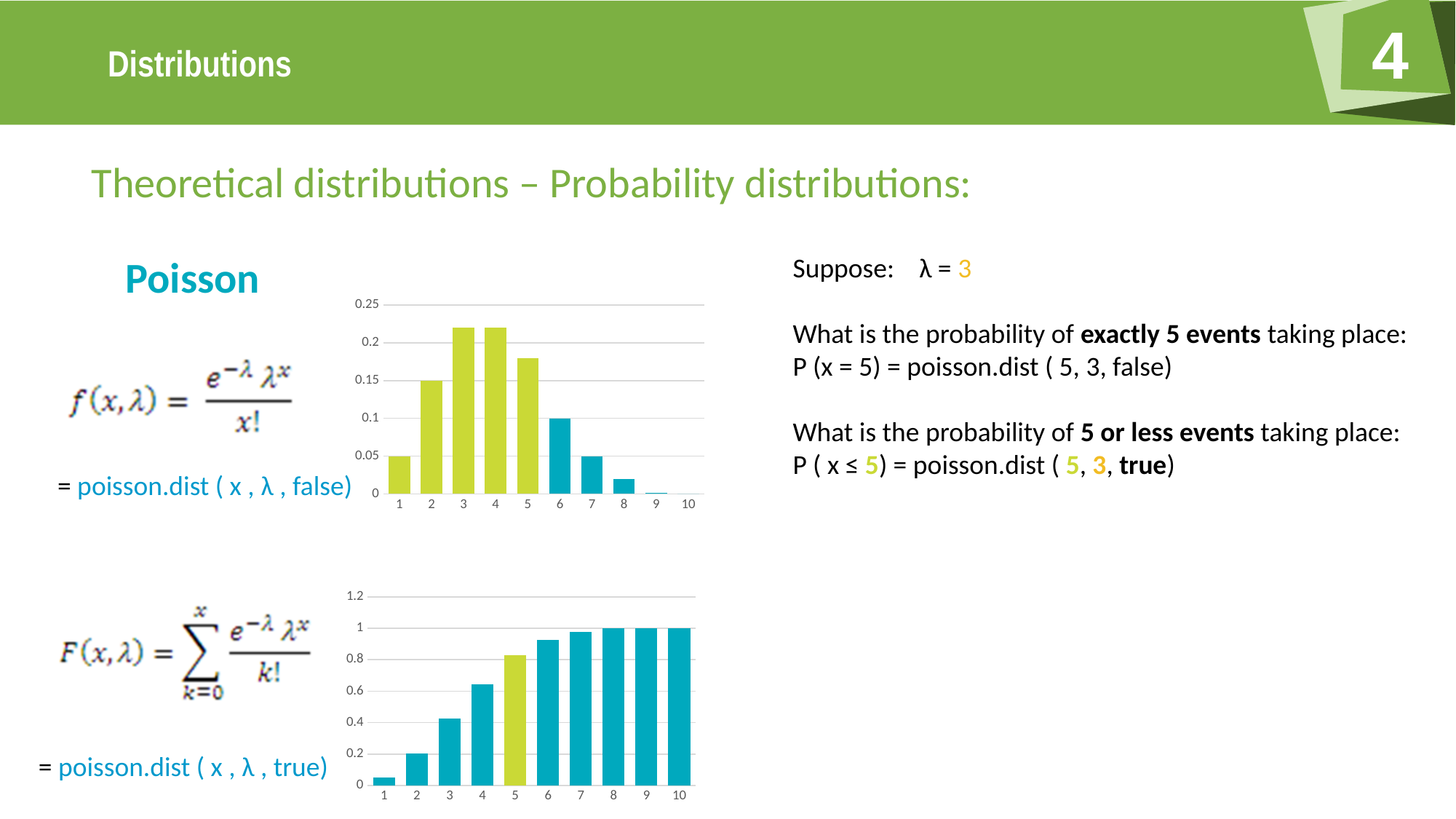
In the bottom chart, which bar is coloured differently (green) from the others? category 5 In the top chart, what is the value for category 1? 0.05 In the bottom chart, is the value for category 4 greater or less than 0.6? greater In the top chart, which is larger, the value for category 2 or the value for category 6? category 2 In the bottom chart, which category has the lowest value? 1 In the bottom chart, what is the value for category 2? 0.2 In the top chart, is the value for category 5 greater or less than 0.15? greater What kind of chart is the top chart on the slide? bar chart How many categories are shown on the x axis of the bottom chart? 10 In the bottom chart, do the values rise or fall as you move from category 1 to category 10? rise In the bottom chart, what is the value for category 10? 1 In the top chart, what is the value for category 6? 0.1